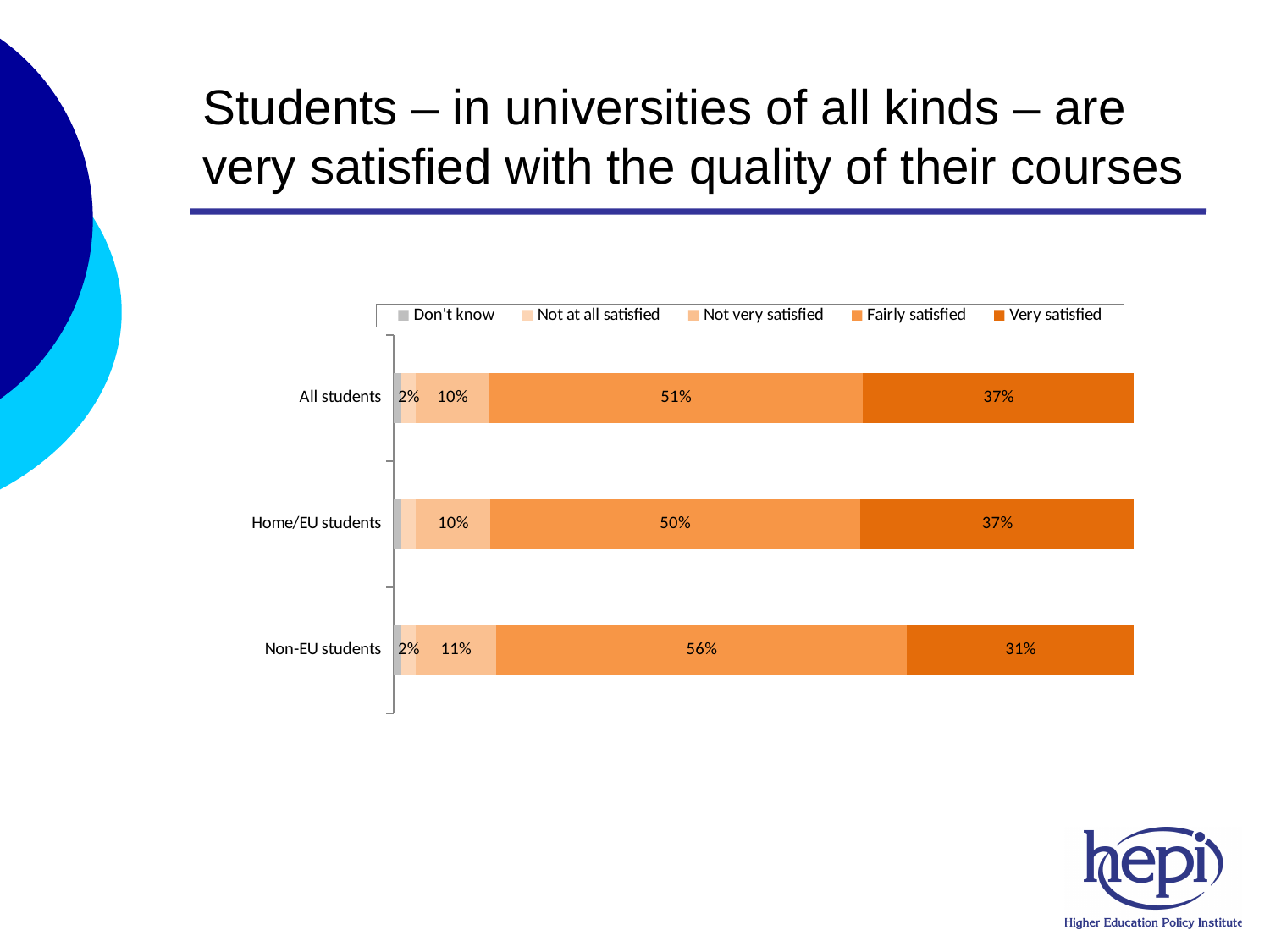
Which student group has the highest Fairly satisfied percentage? Non-EU students Which student group has the lowest Very satisfied percentage? Non-EU students How many percentage points higher is the Fairly satisfied share for Non-EU students than for All students? 5 percentage points What percentage of Non-EU students are Not very satisfied? 11% Which group has a larger Very satisfied share, All students or Non-EU students? All students How many student groups are shown in the chart? 3 What percentage of Non-EU students are Very satisfied? 31% What percentage of All students are Fairly satisfied? 51% What percentage of Home/EU students are Very satisfied? 37% How many series does the legend list? 5 What kind of chart is shown on the slide? Stacked bar chart What percentage of Home/EU students are Fairly satisfied? 50%